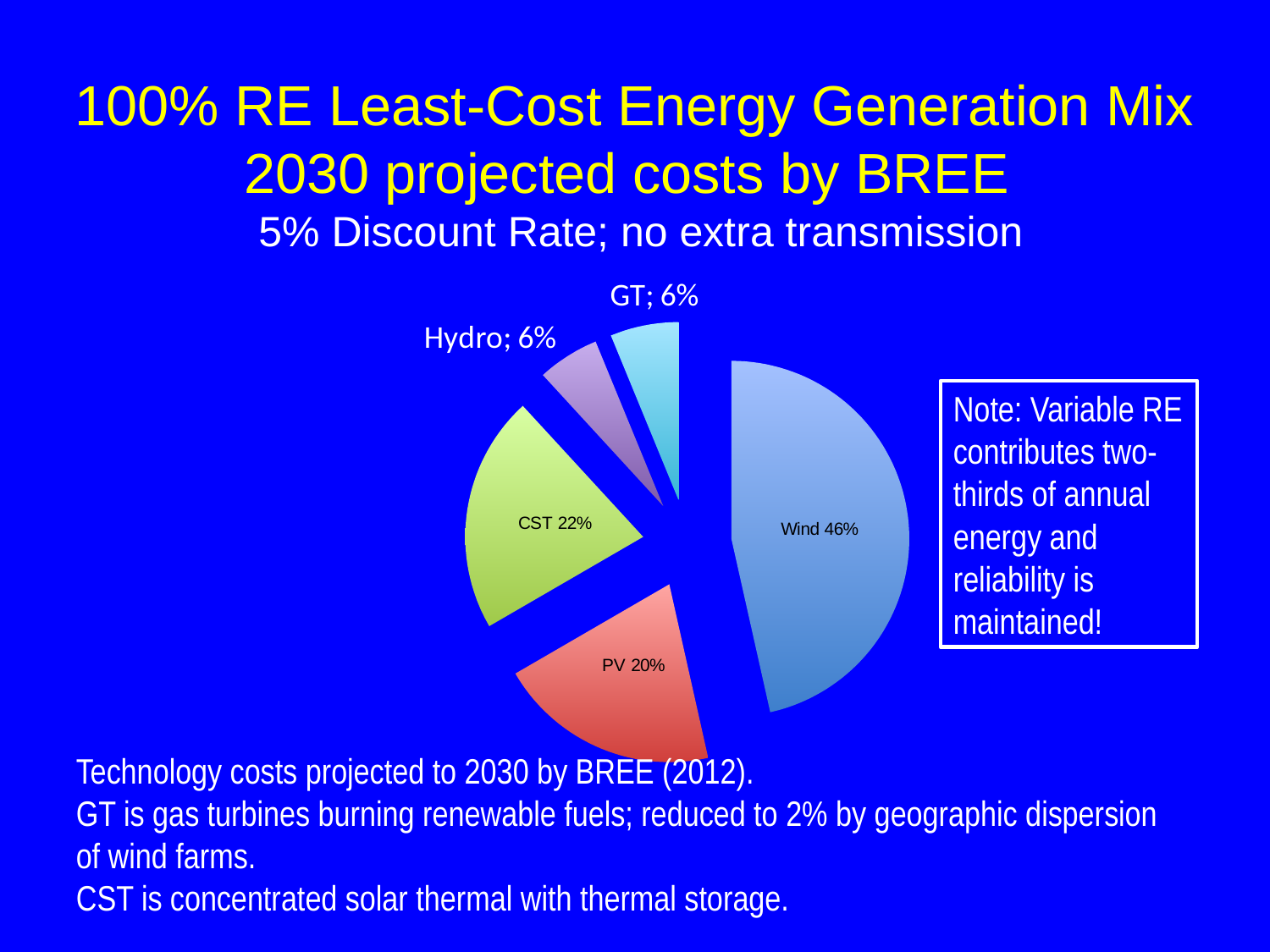
What kind of chart is shown on the slide? pie chart What colour is the Wind slice of the pie? blue How many slices does the pie chart have? 5 What is the difference in percentage points between the Wind and CST slices? 24 Which slice is larger, CST or PV? CST Which category has the largest slice of the pie? Wind What share of the pie does PV have? 20% What share of the pie does Hydro have? 6% What share of the pie does Wind have? 46% What share of the pie does CST have? 22% What share of the pie does GT have? 6% What is the combined share of the Wind and PV slices? 66%